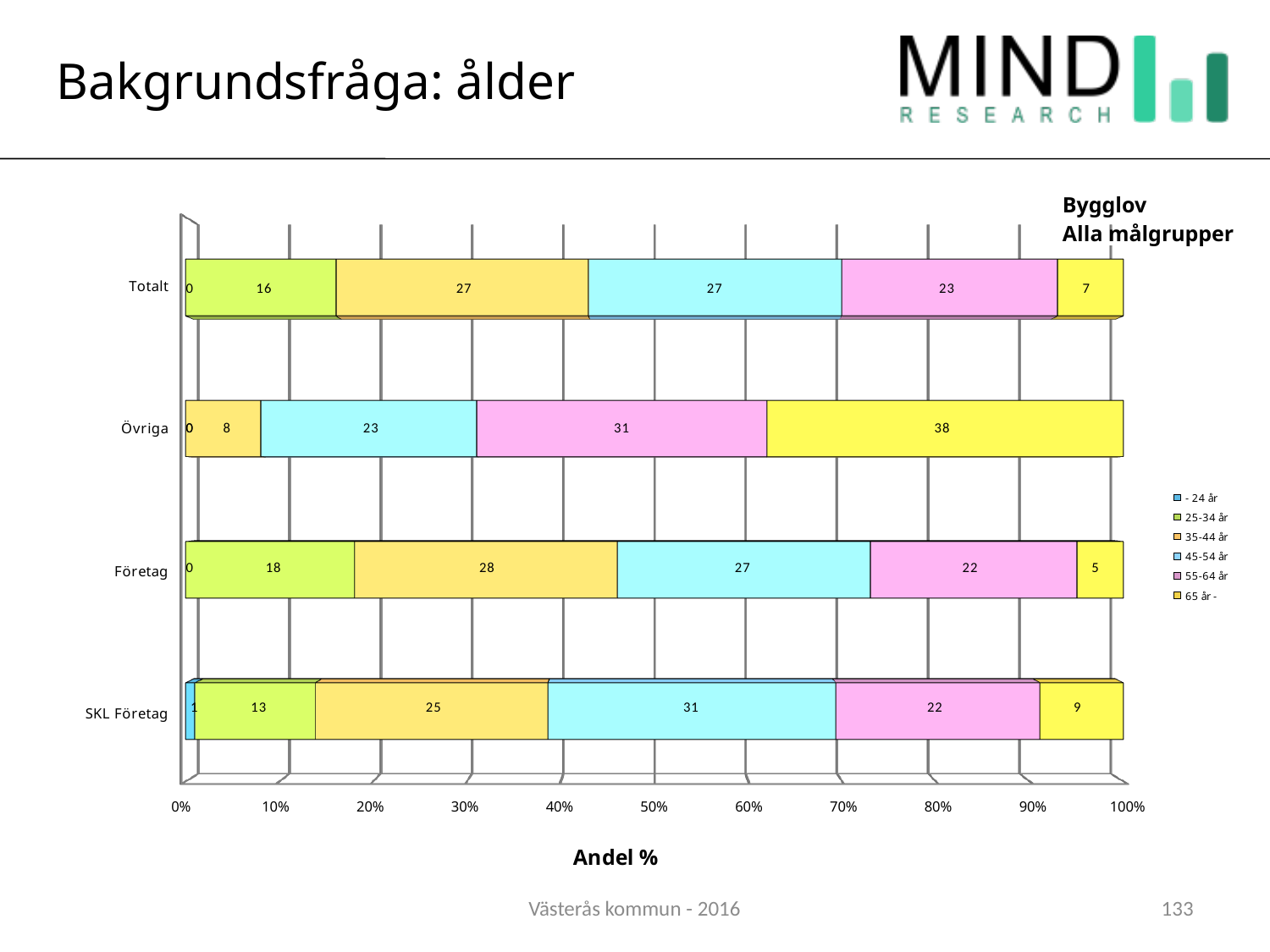
What is the difference between the 55-64 år values for Övriga and Företag? 9 What is the label of the horizontal axis? Andel % What kind of chart is shown on the slide? Stacked bar chart How many series does the legend list? 6 What is the value for the 45-54 år series in the SKL Företag bar? 31 Which category has the highest value for the 65 år - series? Övriga What is the value for the 25-34 år series in the Företag bar? 18 Which category has the lowest value for the 25-34 år series? Övriga Which is larger: the 35-44 år value for Företag or for SKL Företag? Företag What is the value for the 35-44 år series in the Totalt bar? 27 How many categories are shown on the vertical axis? 4 What is the value for the 65 år - series in the Övriga bar? 38